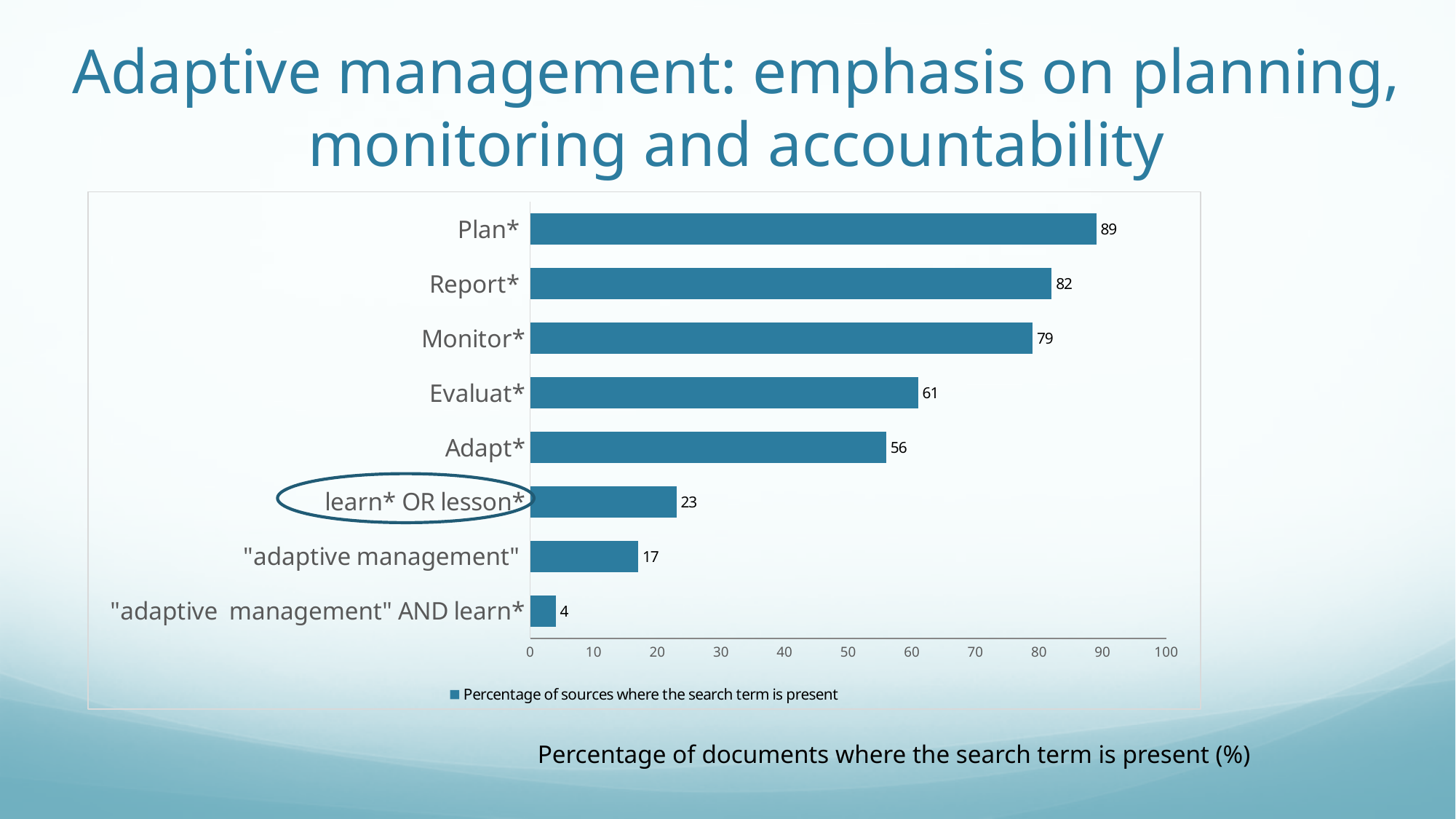
What kind of chart is shown on the slide? bar chart What is the difference between the values for Report* and Evaluat*? 21 Which category has the lowest value? "adaptive management" AND learn* What is the legend entry for the series in the chart? Percentage of sources where the search term is present What is the value for "adaptive management"? 17 Which category has the highest value? Plan* Which is larger, the value for Adapt* or the value for learn* OR lesson*? Adapt* What is the value for Plan*? 89 How many series does the legend list? 1 Is the value for Evaluat* greater or less than 50? greater How many categories are shown in the chart? 8 What is the value for Monitor*? 79